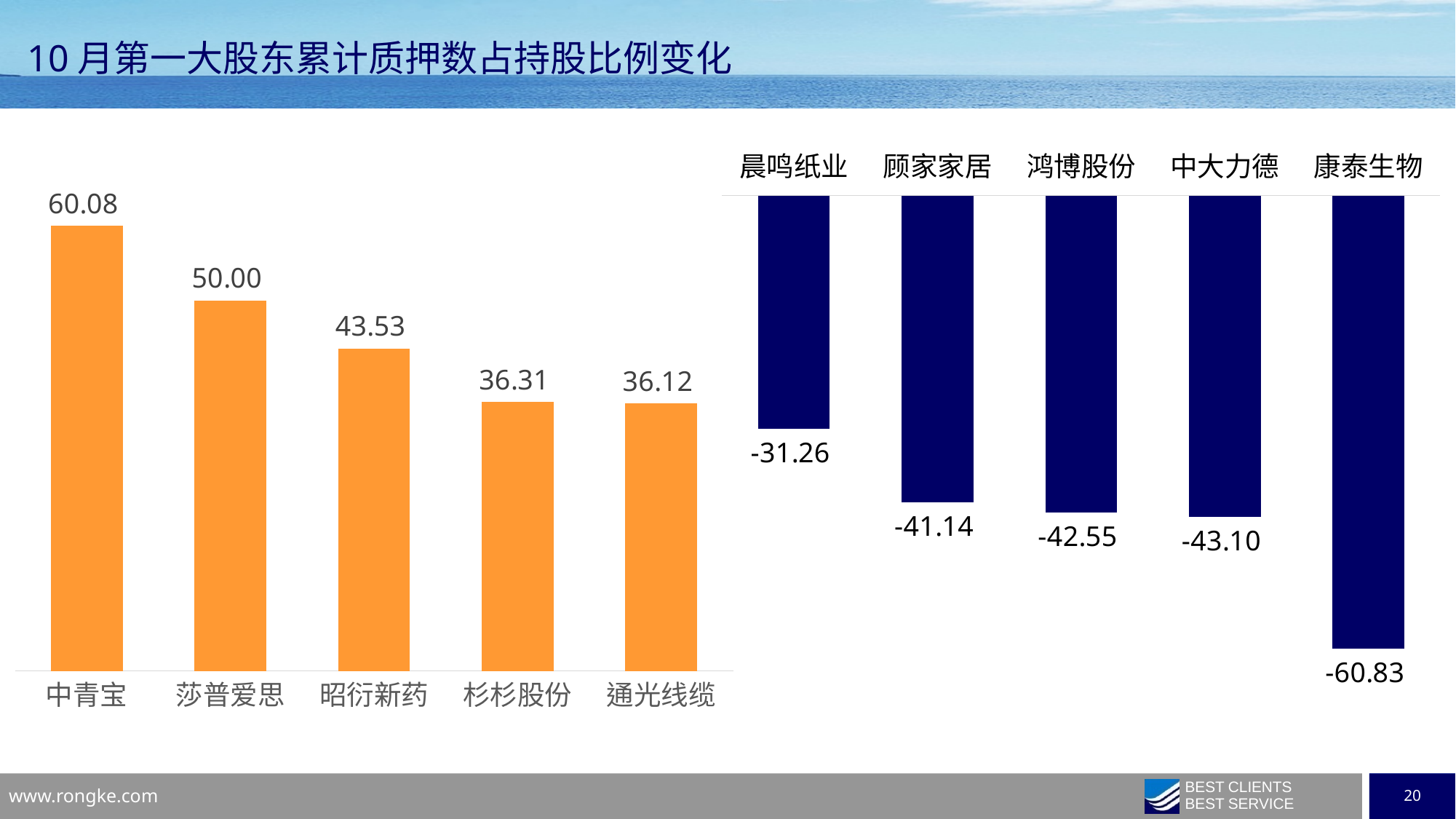
How many categories are shown in the left chart? 5 In the left chart, which category has the lowest value? 通光线缆 In the right chart, what is the value for 康泰生物? -60.83 In the left chart, what is the difference between the values for 中青宝 and 莎普爱思? 10.08 What kind of chart is the right chart? bar chart In the left chart, which category has the highest value? 中青宝 In the right chart, which category has the highest value? 晨鸣纸业 In the left chart, what is the value for 中青宝? 60.08 In the right chart, what is the value for 鸿博股份? -42.55 In the left chart, what is the value for 昭衍新药? 43.53 In the right chart, what is the difference between the values for 晨鸣纸业 and 顾家家居? 9.88 In the right chart, which category has the lowest value? 康泰生物